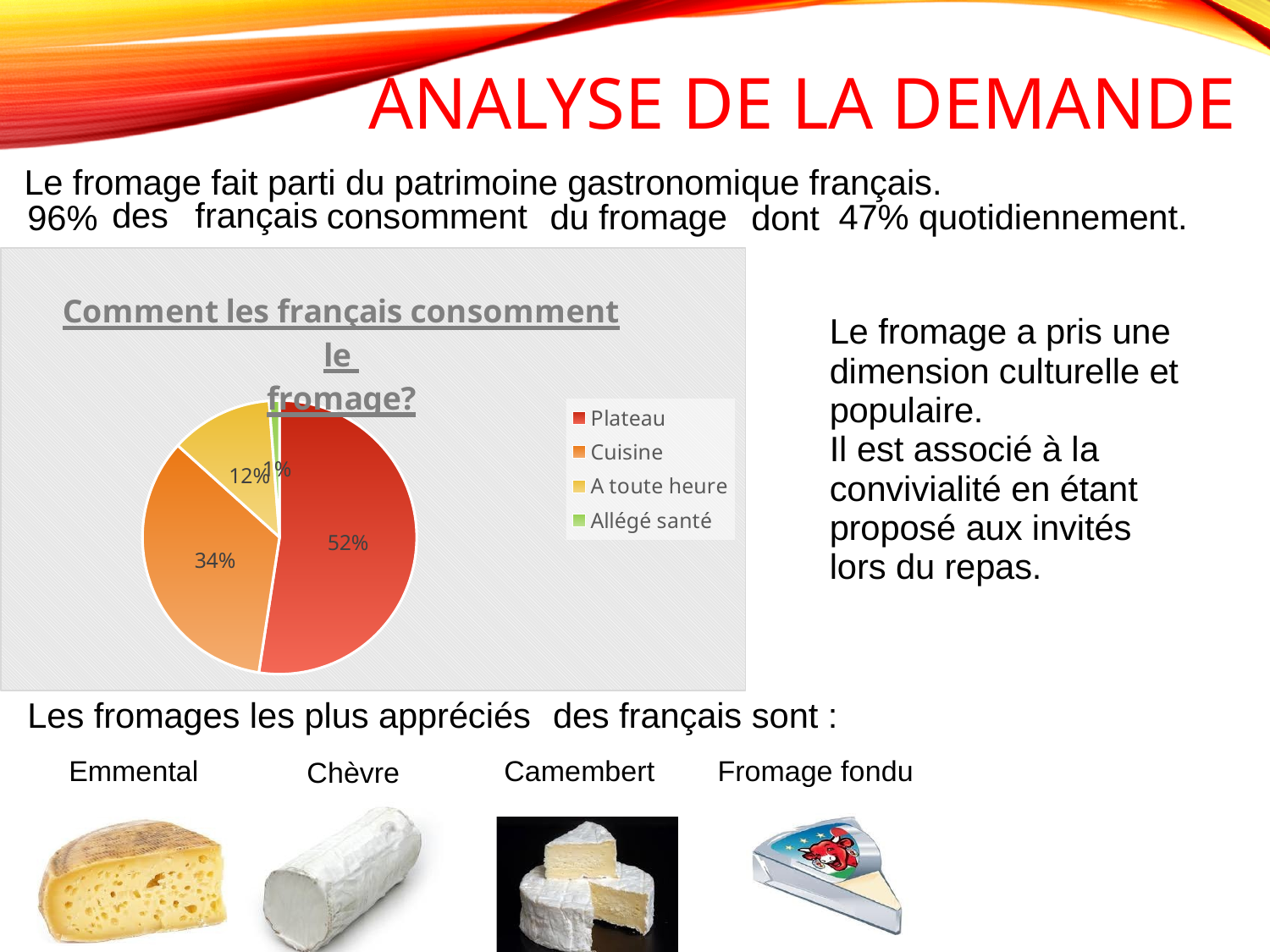
What kind of chart is shown on the slide? pie chart What share of the pie does Cuisine represent? 34% Which category has the smallest slice of the pie? Allégé santé What share of the pie does Plateau represent? 52% What is the difference in percentage points between Plateau and Cuisine? 18 Which is larger, the slice for Cuisine or the slice for A toute heure? Cuisine How many entries does the legend of the pie chart list? 4 What colour is the Plateau slice in the pie chart? red What share of the pie does A toute heure represent? 12% Which category has the largest slice of the pie? Plateau What is the title of the pie chart? Comment les français consomment le fromage? How many slices does the pie chart have? 4